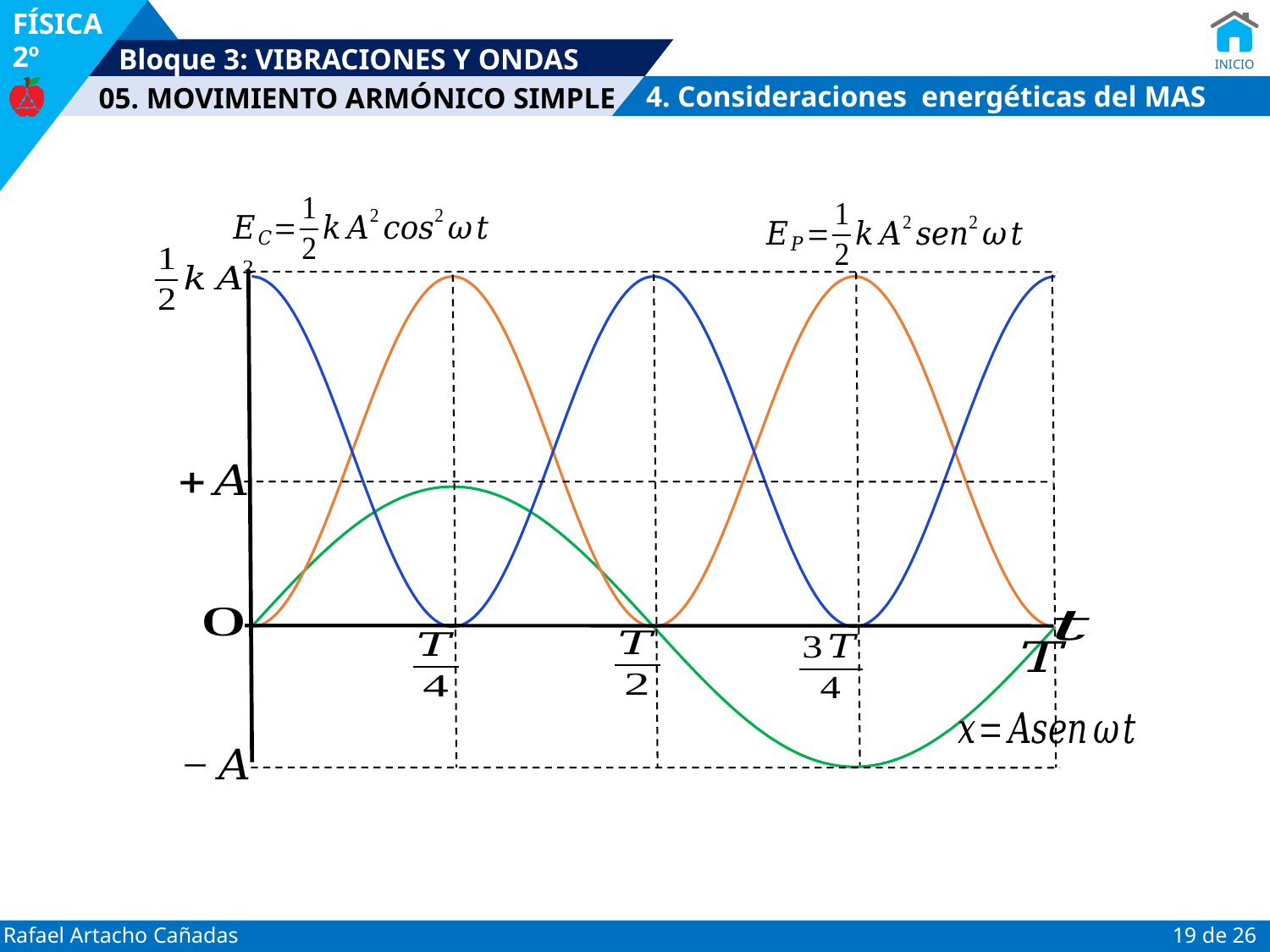
What is the value of the green curve (x = A sen ωt) at t = 3T/4? −A At t = T/2, which is larger, the blue curve (E_C) or the orange curve (E_P)? blue curve (E_C) Does the green curve (x = A sen ωt) rise or fall between t = T/4 and t = 3T/4? fall What is the value of the blue curve (E_C) at t = 0? ½kA² What is the value of the blue curve (E_C) at t = T/4? 0 What kind of chart is shown on the slide? line chart Which equation is written next to the green curve? x = A sen ωt At t = 3T/4, which is larger, the blue curve (E_C) or the orange curve (E_P)? orange curve (E_P) What is the value of the orange curve (E_P) at t = T/4? ½kA² What is the label on the horizontal axis of the chart? t How many curves are plotted on the chart? 3 What is the value of the green curve (x = A sen ωt) at t = T/4? +A